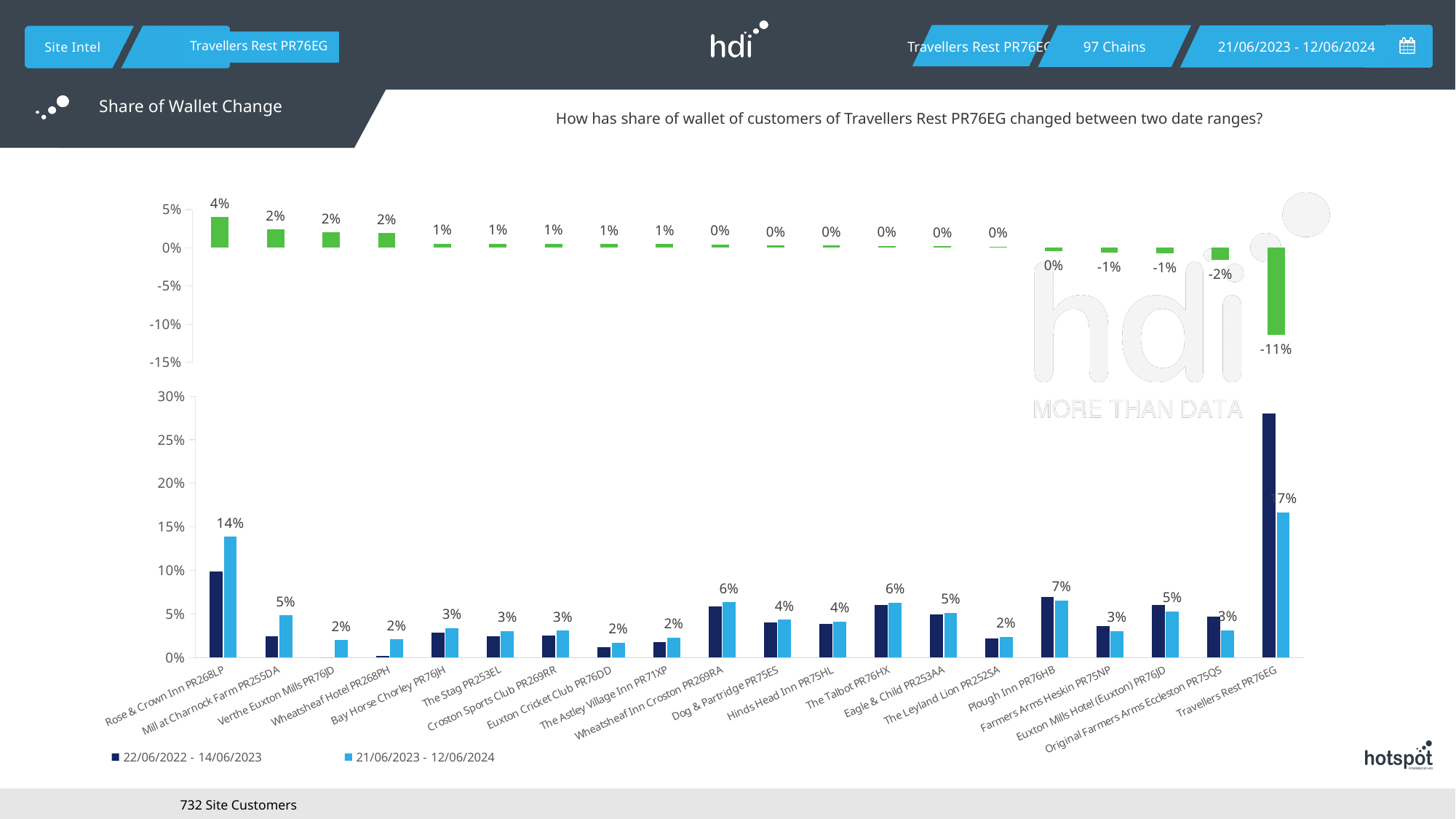
In the top chart, what is the share of wallet change for Travellers Rest PR76EG? -11% How many series does the legend of the bottom chart list? 2 In the bottom chart, what is the 21/06/2023 - 12/06/2024 value for Plough Inn PR76HB? 7% How many sites are shown on the x axis of the bottom chart? 20 In the top chart, which site has the lowest share of wallet change? Travellers Rest PR76EG In the top chart, which site has the highest share of wallet change? Rose & Crown Inn PR268LP In the bottom chart, which has the larger 21/06/2023 - 12/06/2024 value: Rose & Crown Inn PR268LP or Mill at Charnock Farm PR255DA? Rose & Crown Inn PR268LP What kind of chart is the top chart showing share of wallet change? Bar chart In the bottom chart, is the 22/06/2022 - 14/06/2023 value for Travellers Rest PR76EG greater or less than 25%? greater In the top chart, what is the difference between the share of wallet change for Rose & Crown Inn PR268LP and Mill at Charnock Farm PR255DA? 2 percentage points In the bottom chart, what is the 21/06/2023 - 12/06/2024 value for Rose & Crown Inn PR268LP? 14% In the top chart, what is the share of wallet change for Original Farmers Arms Eccleston PR75QS? -2%